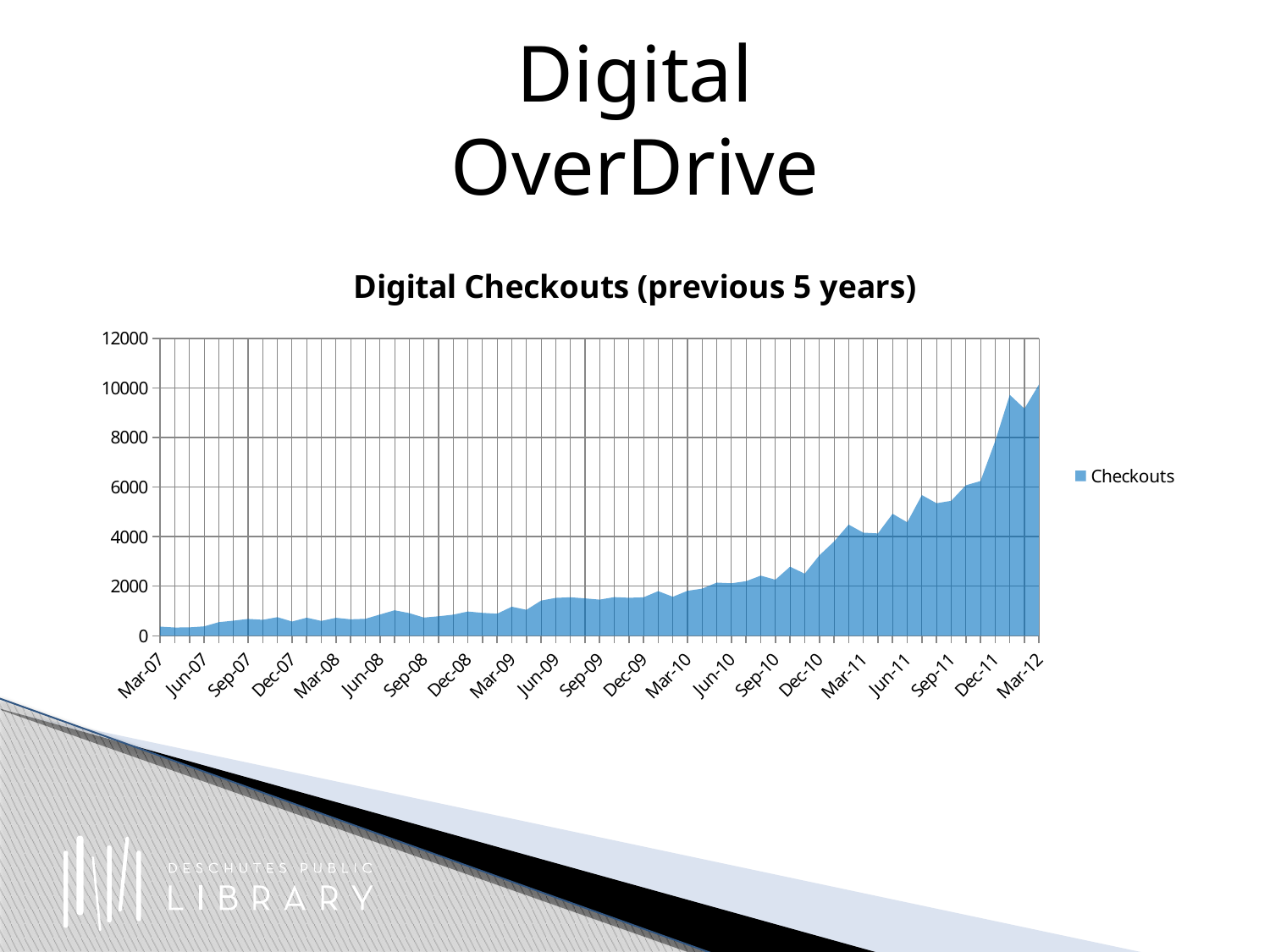
What is the title of the chart? Digital Checkouts (previous 5 years) Which has the larger value, Mar-12 or Mar-07? Mar-12 Which has the larger value, Dec-10 or Dec-08? Dec-10 Do the checkout values generally rise or fall from Mar-07 to Mar-12? rise What kind of chart is shown on the slide? area chart Is the value for Mar-11 greater or less than 2000? greater Is the value for Jun-10 greater or less than 4000? less Is the value for Mar-12 greater or less than 8000? greater What series name does the legend show? Checkouts How many series does the legend list? 1